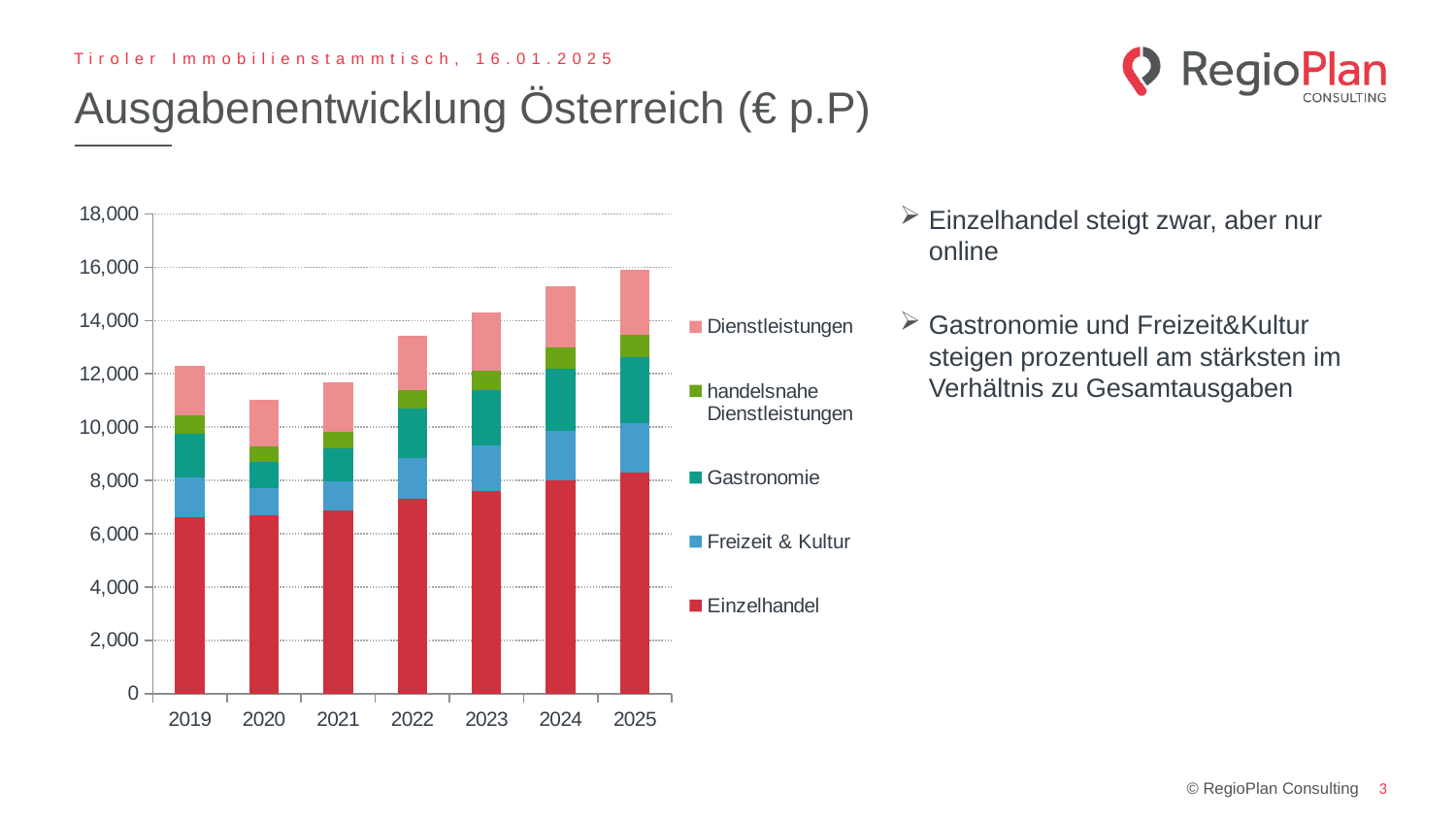
Which year has the larger total bar, 2020 or 2021? 2021 Which series forms the bottom segment of each stacked bar? Einzelhandel Which year has the highest total bar in the chart? 2025 Is the total value for 2020 greater or less than 12,000? less How many series does the chart legend list? 5 Is the total value for 2025 greater or less than 14,000? greater Which year has the lowest total bar in the chart? 2020 What kind of chart is shown on the slide? Stacked bar chart What is the title of the chart on the slide? Ausgabenentwicklung Österreich (€ p.P) Is the Einzelhandel value for 2019 greater or less than 6,000? greater How many years are shown on the x axis of the chart? 7 From 2020 to 2025, do the total bar heights rise or fall? Rise